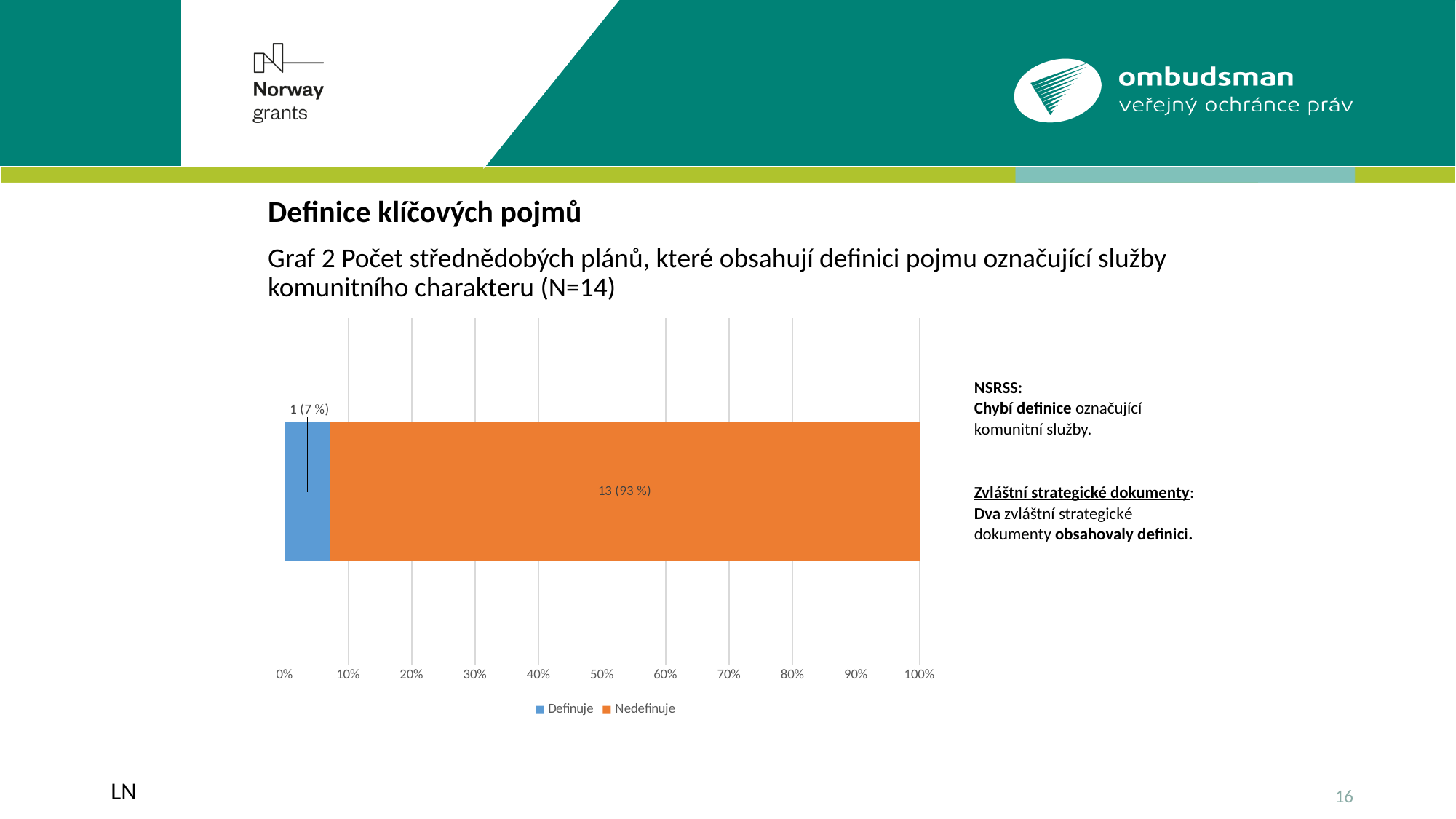
What kind of chart is shown on the slide? Stacked bar chart What is the data label shown for the Nedefinuje segment of the bar? 13 (93 %) Which series has the smallest value in the chart? Definuje What is the total count across both segments of the stacked bar? 14 What is the difference in count between the Nedefinuje and Definuje segments? 12 What is the data label shown for the Definuje segment of the bar? 1 (7 %) What is the highest value shown on the horizontal axis of the chart? 100% Is the share for Nedefinuje greater or less than 50%? greater Which series has the larger value, Definuje or Nedefinuje? Nedefinuje What colour is the Nedefinuje series in the chart? Orange How many series does the legend list? 2 Is the share for Definuje greater or less than 10%? less